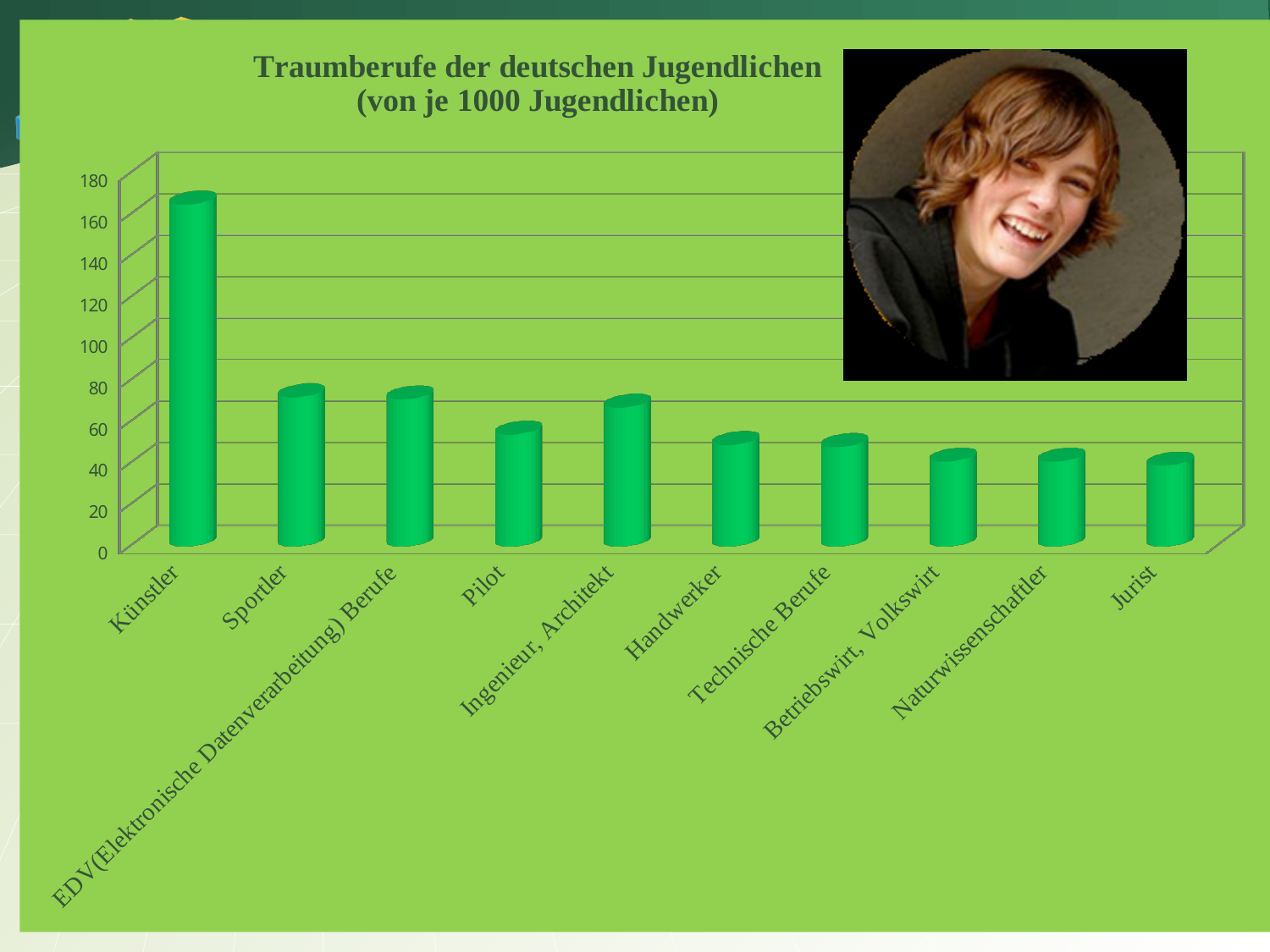
How many categories (professions) are shown on the x axis? 10 Which is larger, the value for Sportler or the value for Jurist? Sportler Which is larger, the value for Pilot or the value for Ingenieur, Architekt? Ingenieur, Architekt What colour are the bars in the chart? green Is the value for Künstler greater or less than 140? greater Is the value for Pilot greater or less than 80? less Which is larger, the value for Künstler or the value for Sportler? Künstler Is the value for Ingenieur, Architekt greater or less than 60? greater Which profession has the highest value? Künstler What is the title of the chart? Traumberufe der deutschen Jugendlichen (von je 1000 Jugendlichen) What kind of chart is shown on the slide? bar chart